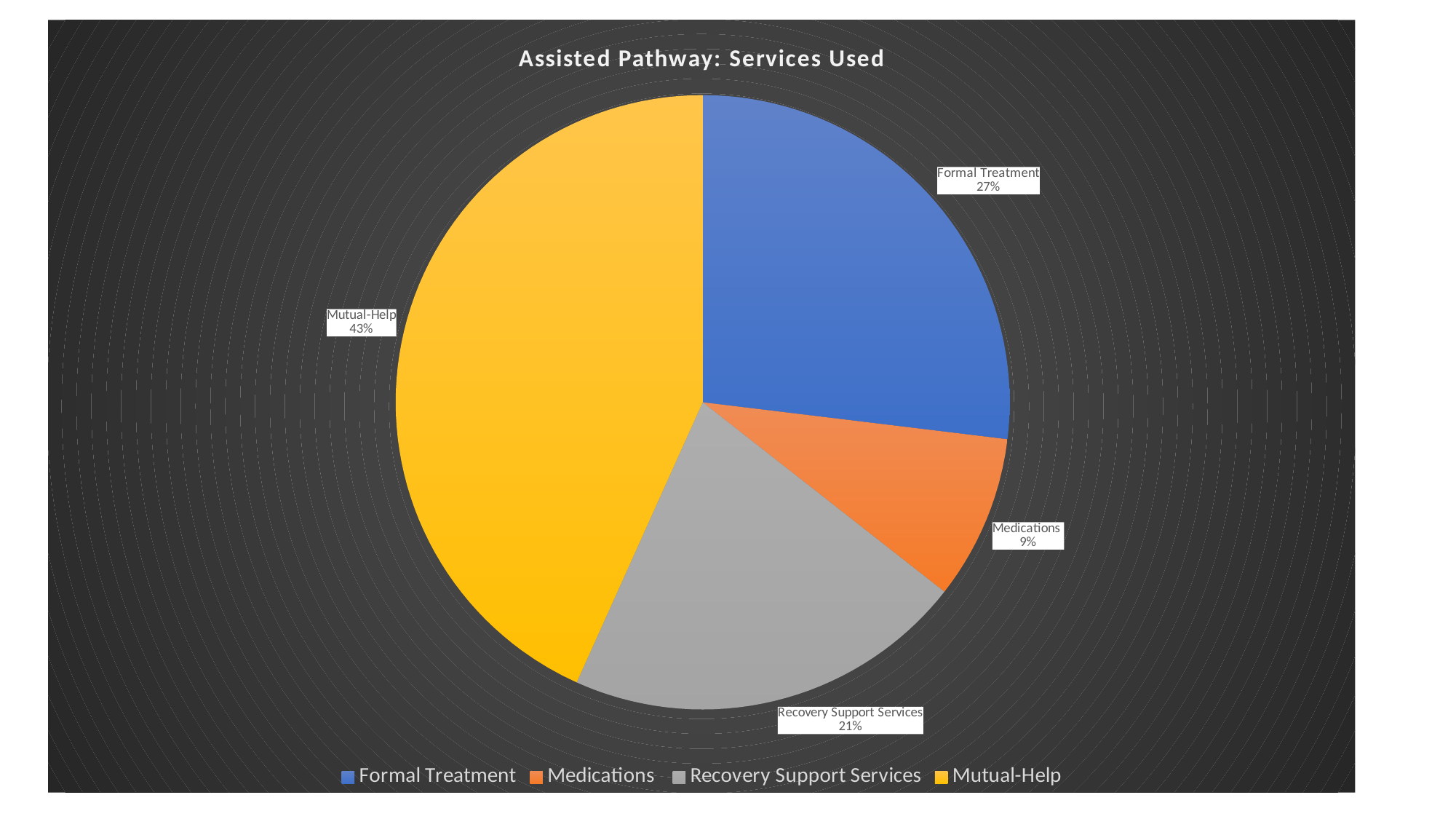
What kind of chart is shown on the slide? Pie chart What is the difference in percentage points between Mutual-Help and Formal Treatment? 16 Which is larger, Recovery Support Services or Medications? Recovery Support Services What percentage of the pie is Recovery Support Services? 21% Which category has the largest slice of the pie? Mutual-Help Which category has the smallest slice of the pie? Medications How many categories are shown in the pie chart? 4 What colour is the Recovery Support Services slice? Grey What percentage of the pie is Medications? 9% What percentage of the pie is Formal Treatment? 27% What is the title of the chart? Assisted Pathway: Services Used What percentage of the pie is Mutual-Help? 43%